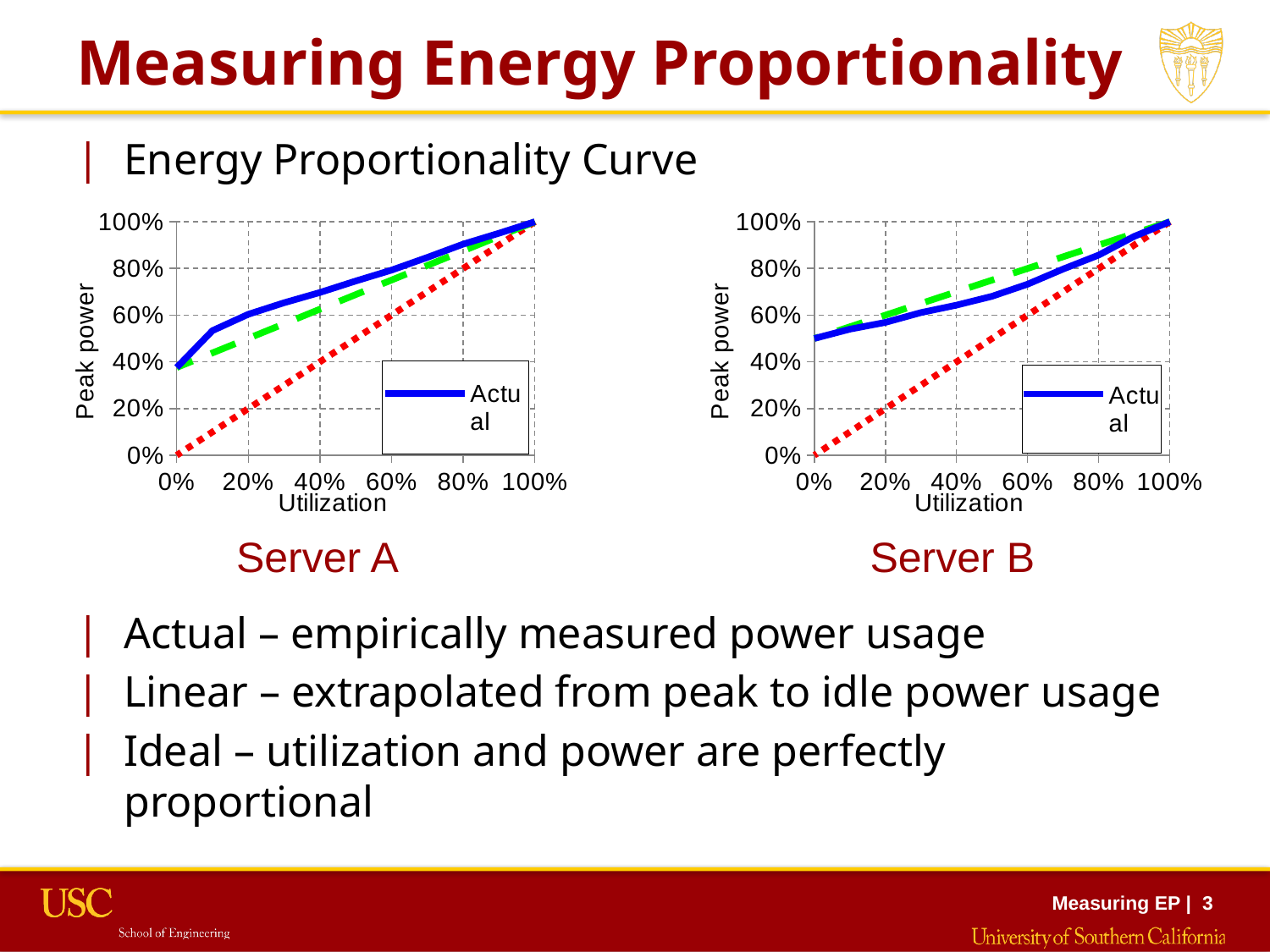
In the Server B chart, does the Actual peak power rise or fall as utilization increases? rise What kind of chart is the Server A chart? line chart In the Server A chart, at 50% utilization, which line is higher, the Actual line or the dotted Ideal line? Actual In the Server B chart, is the Actual peak power at 60% utilization greater or less than 80%? less In the Server B chart, is the Actual peak power at 0% utilization greater or less than 40%? greater In the Server B chart, what is the value of the dotted Ideal line at 0% utilization? 0% In the Server A chart, what is the Actual peak power at 100% utilization? 100% In the Server A chart, is the Actual peak power at 40% utilization greater or less than 60%? greater In the Server B chart, what is the label on the x axis? Utilization In the Server A chart, what is the label on the y axis? Peak power At 0% utilization, which server has the higher Actual peak power, Server A or Server B? Server B